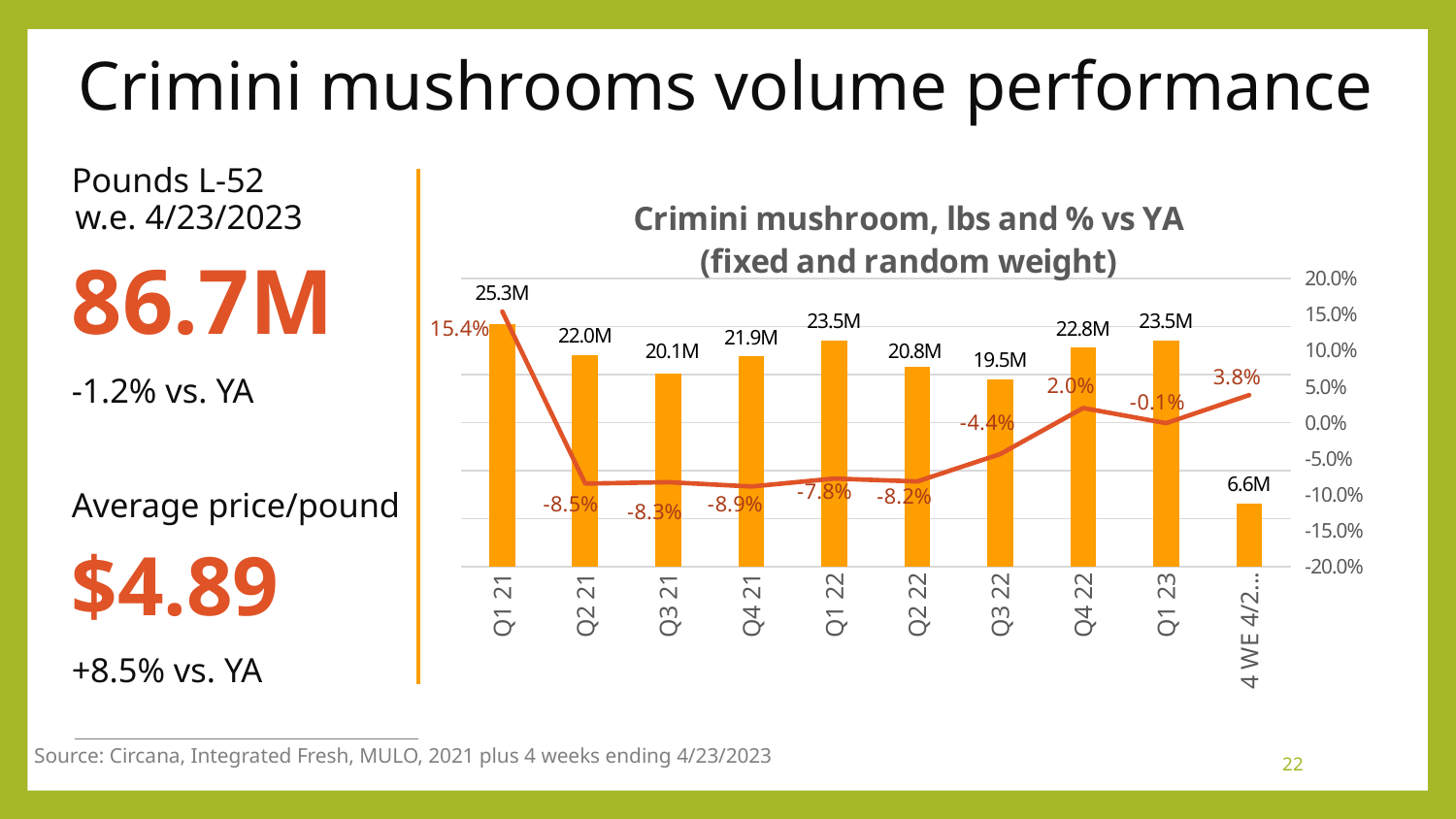
How many categories are shown on the x axis? 10 Which quarter has the highest pounds value? Q1 21 What is the pounds value for Q4 22? 22.8M What is the pounds value for Q1 21? 25.3M Which quarter has the lowest pounds value among the full quarters (Q1 21 to Q1 23)? Q3 22 What is the title of the chart? Crimini mushroom, lbs and % vs YA (fixed and random weight) What is the % vs YA value for Q2 21? -8.5% What is the % vs YA value for Q3 22? -4.4% What kind of chart is this? Combination bar and line chart What is the difference in pounds between Q1 21 and Q2 21? 3.3M Which is larger, the pounds value for Q4 21 or Q2 22? Q4 21 Is the % vs YA value for Q1 21 greater or less than 10.0%? greater